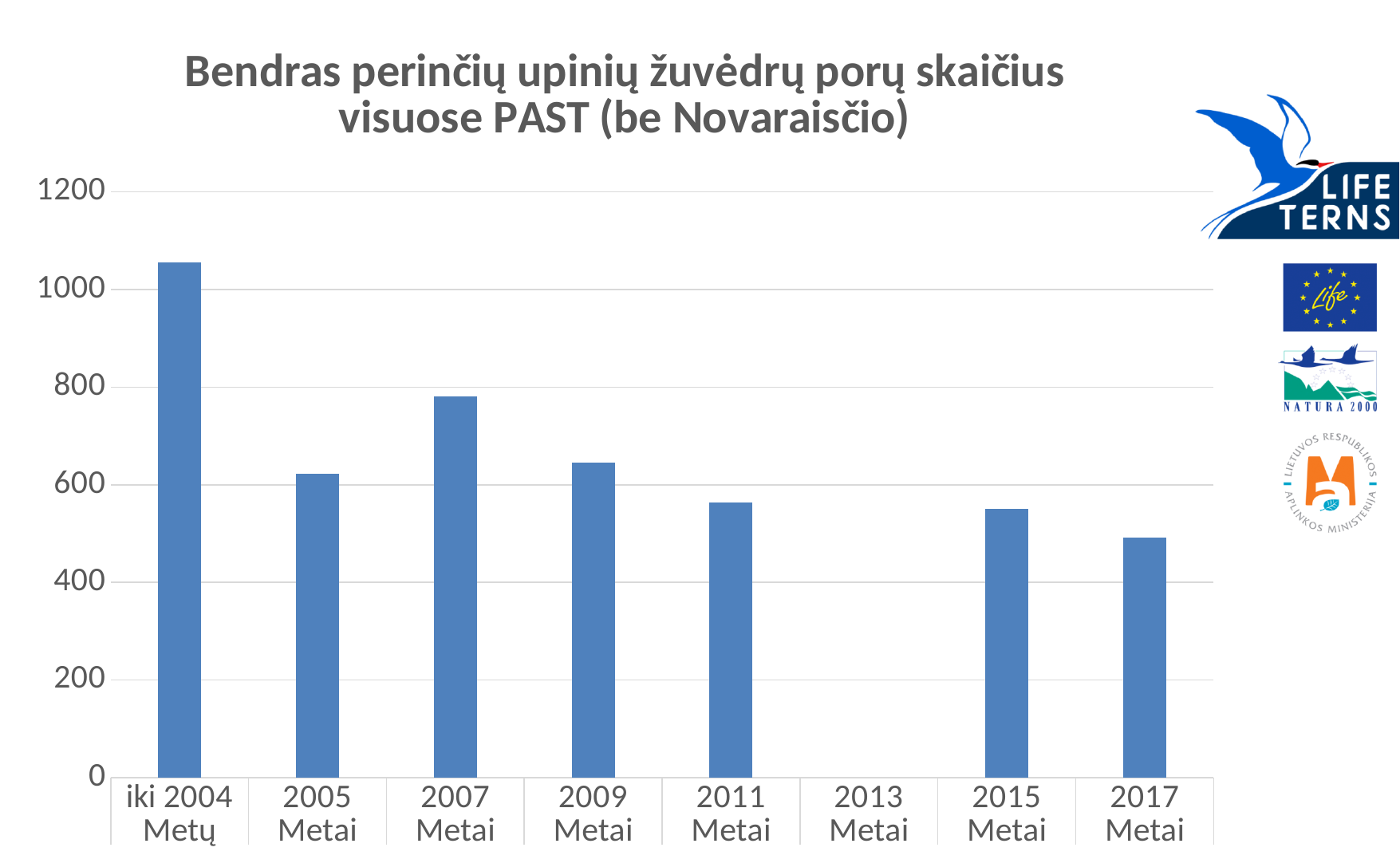
Is the value for 2007 Metai greater or less than 800? less What is the title of the chart? Bendras perinčių upinių žuvėdrų porų skaičius visuose PAST (be Novaraisčio) Is the value for iki 2004 Metų greater or less than 1000? greater Is the value for 2011 Metai greater or less than 600? less Which category has the highest bar? iki 2004 Metų What kind of chart is shown on the slide? bar chart Which is larger, the value for 2007 Metai or the value for 2005 Metai? 2007 Metai How many categories are shown on the x axis of the chart? 8 Overall, do the values rise or fall from iki 2004 Metų to 2017 Metai? fall Which category has no bar plotted at all? 2013 Metai